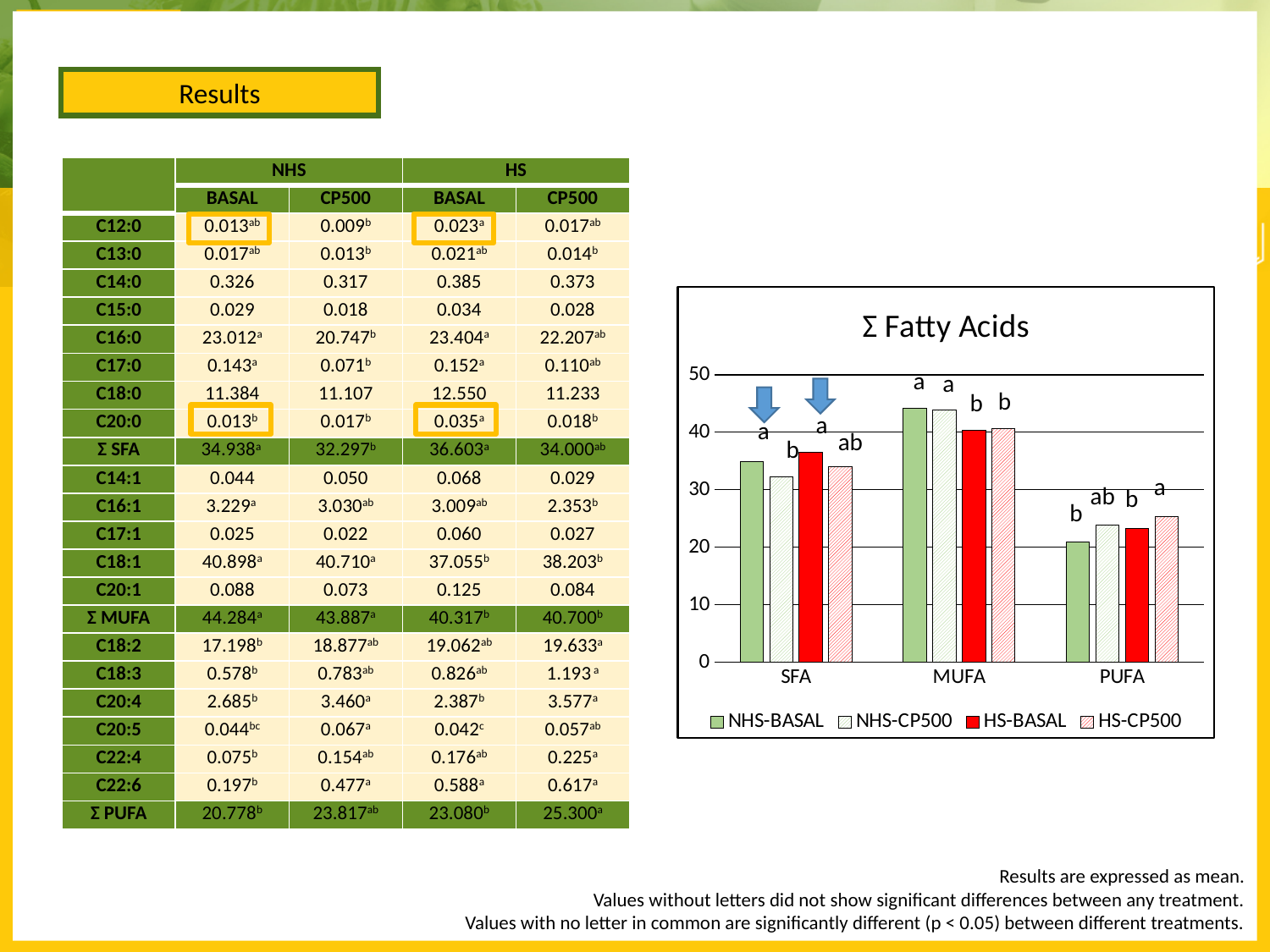
Which category has the highest NHS-BASAL bar in the chart? MUFA What is the title of the chart? Σ Fatty Acids Which series is drawn in solid red in the chart? HS-BASAL Is the NHS-BASAL value for PUFA greater or less than 30? less Is the HS-CP500 value for PUFA greater or less than 20? greater What type of chart is shown on the slide? bar chart Is the NHS-BASAL value for MUFA greater or less than 40? greater How many categories are shown on the x axis of the chart? 3 Which category has the lowest NHS-BASAL bar in the chart? PUFA For PUFA, which is larger: the NHS-BASAL bar or the HS-CP500 bar? HS-CP500 For MUFA, which is larger: the NHS-BASAL bar or the HS-BASAL bar? NHS-BASAL How many series does the chart legend list? 4